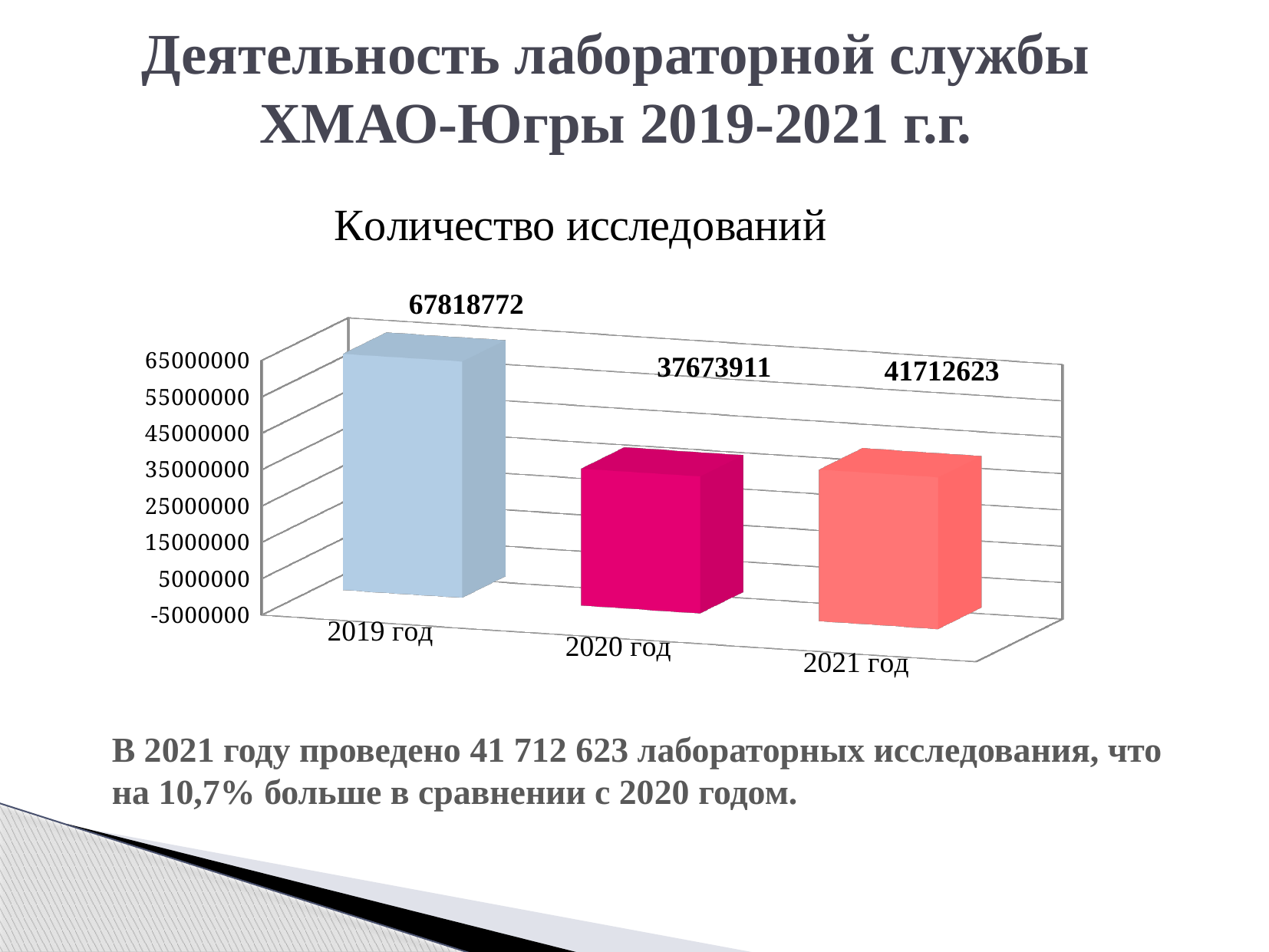
What is the difference between the values for 2019 год and 2020 год? 30144861 Which year has the lowest number of исследований in the chart? 2020 год How many years (categories) are shown in the chart? 3 What is the value for 2019 год in the chart "Количество исследований"? 67818772 What kind of chart is shown on the slide? bar chart Do the values rise or fall from 2020 год to 2021 год? rise Is the value for 2019 год greater or less than 65000000? greater Which is larger, the value for 2020 год or the value for 2021 год? 2021 год What is the difference between the values for 2021 год and 2020 год? 4038712 Which year has the highest number of исследований in the chart? 2019 год What is the value for 2021 год in the chart "Количество исследований"? 41712623 What is the value for 2020 год in the chart "Количество исследований"? 37673911